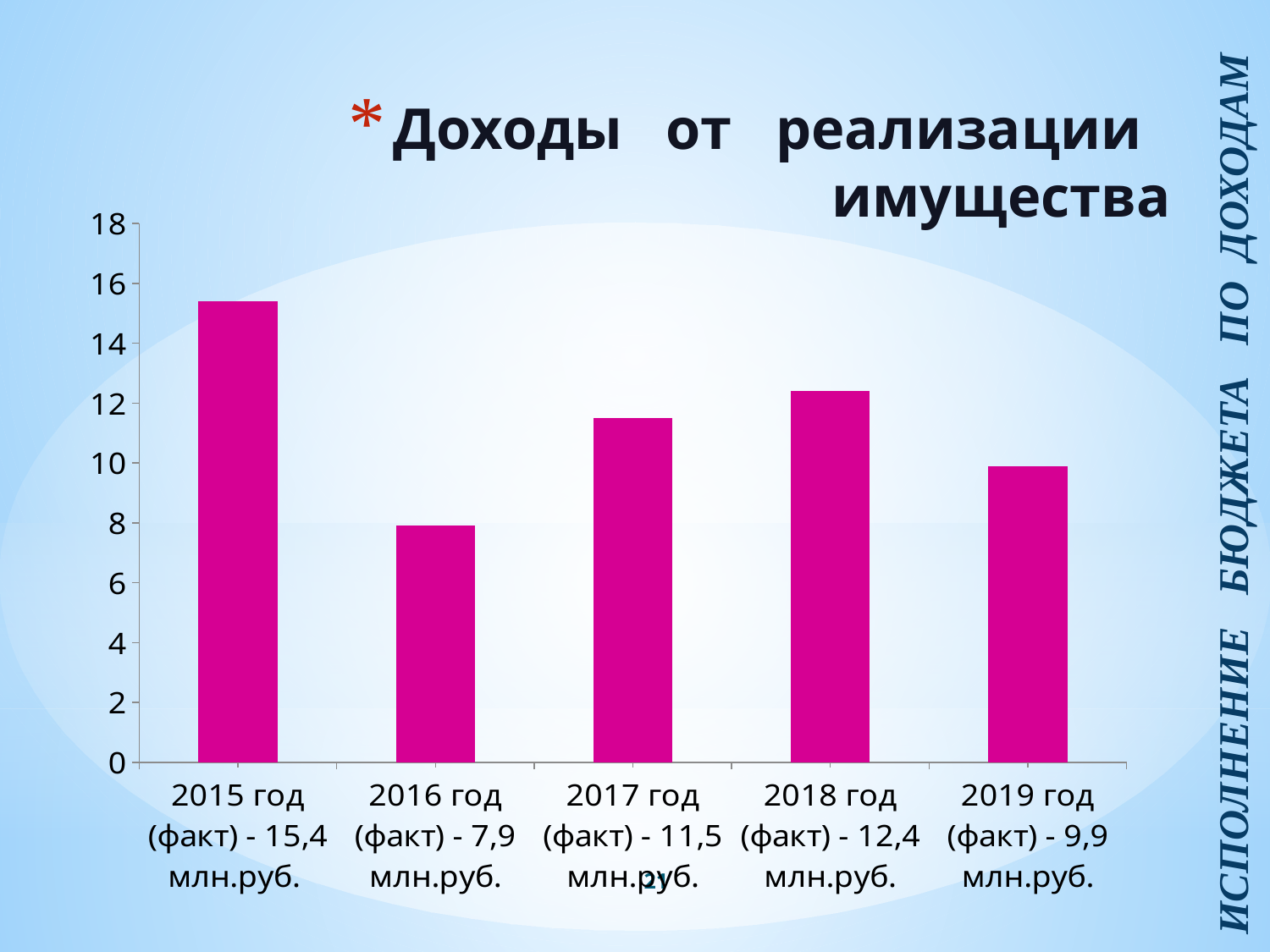
Which year has the highest value in the chart? 2015 год Which is larger, the value for 2018 год or the value for 2017 год? 2018 год How many bars (years) are plotted in the chart? 5 What is the value for 2016 год (факт)? 7,9 млн.руб. What type of chart is shown on the slide? Bar chart Which year has the lowest value in the chart? 2016 год What is the title of the chart on the slide? Доходы от реализации имущества Is the value for 2018 год greater or less than 12? greater What is the value for 2019 год (факт)? 9,9 млн.руб. What is the difference between the values for 2015 год and 2016 год? 7,5 млн.руб. What is the value for 2017 год (факт)? 11,5 млн.руб. What is the value for 2015 год (факт)? 15,4 млн.руб.